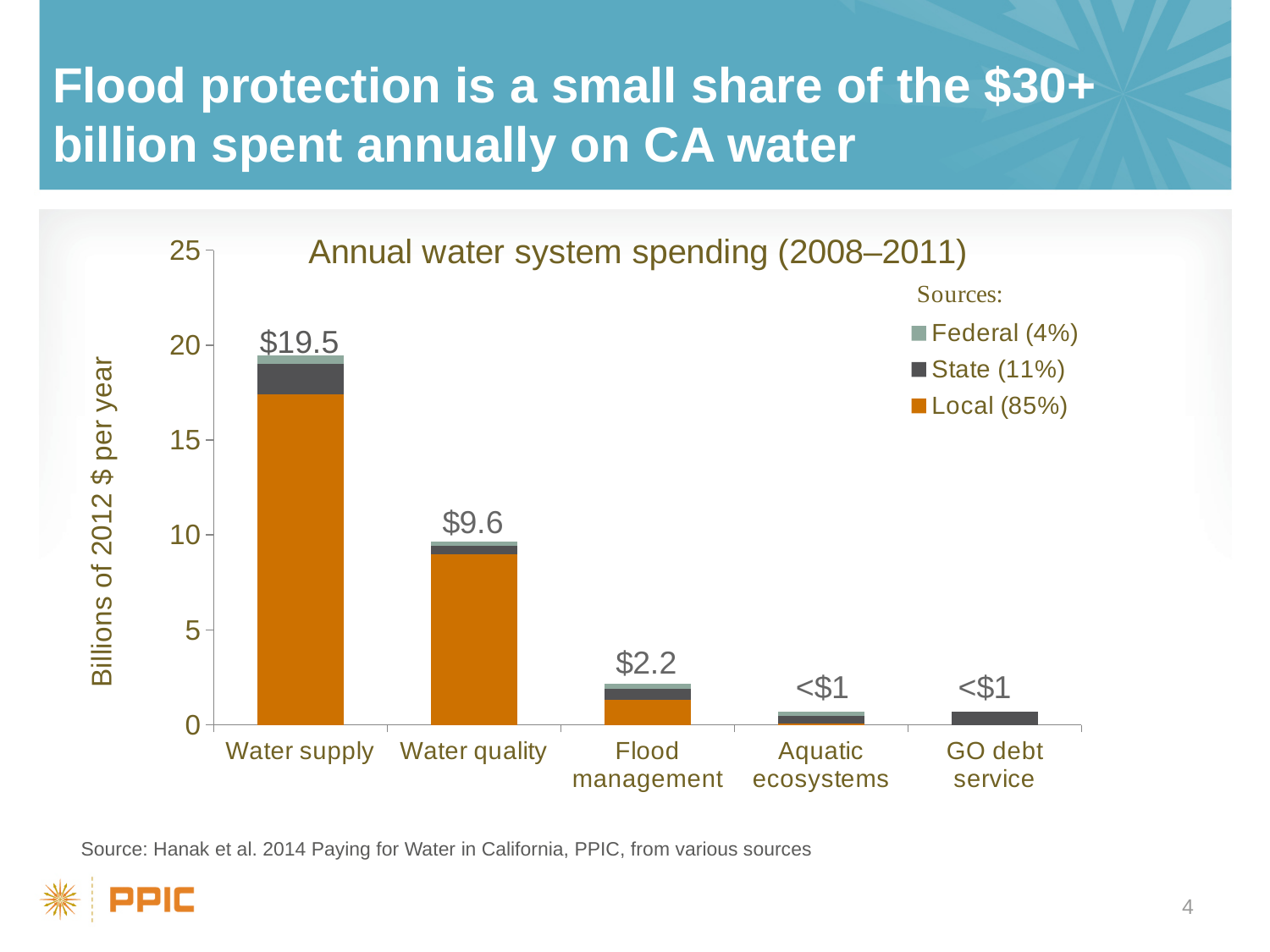
How many spending categories are shown on the x axis? 5 Is the value for Water supply greater or less than 15? greater What is the total annual spending for Water supply? $19.5 Which category has the highest annual spending? Water supply Do the bar totals rise or fall from left to right across the categories? Fall What kind of chart is shown on the slide? Stacked bar chart What is the total annual spending for Flood management? $2.2 What is the total annual spending for Water quality? $9.6 What is the difference between the Water supply and Water quality totals? $9.9 What value is labeled for Aquatic ecosystems? <$1 Which is larger, the spending on Water quality or on Flood management? Water quality How many funding sources does the legend list? 3